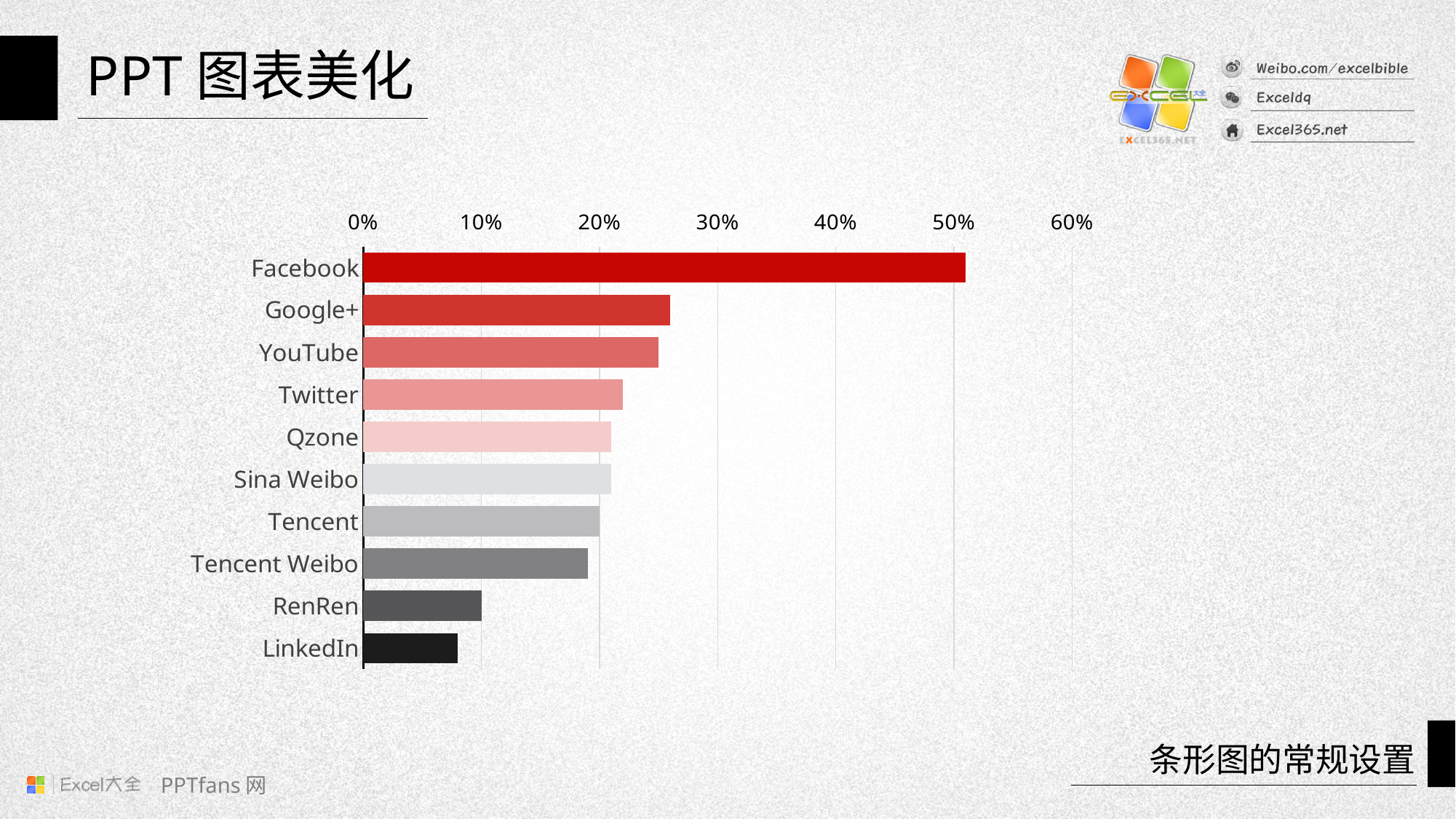
How many categories (platforms) are plotted in the chart? 10 Which has a larger value, Facebook or Google+? Facebook Is the value for Facebook greater or less than 40%? greater Which platform has the lowest value in the chart? LinkedIn What kind of chart is shown on the slide? bar chart Which has a larger value, Twitter or RenRen? Twitter Is the value for LinkedIn greater or less than 10%? less Which platform has the highest value in the chart? Facebook Is the value for Google+ greater or less than 20%? greater What is the highest tick label shown on the percentage axis? 60%